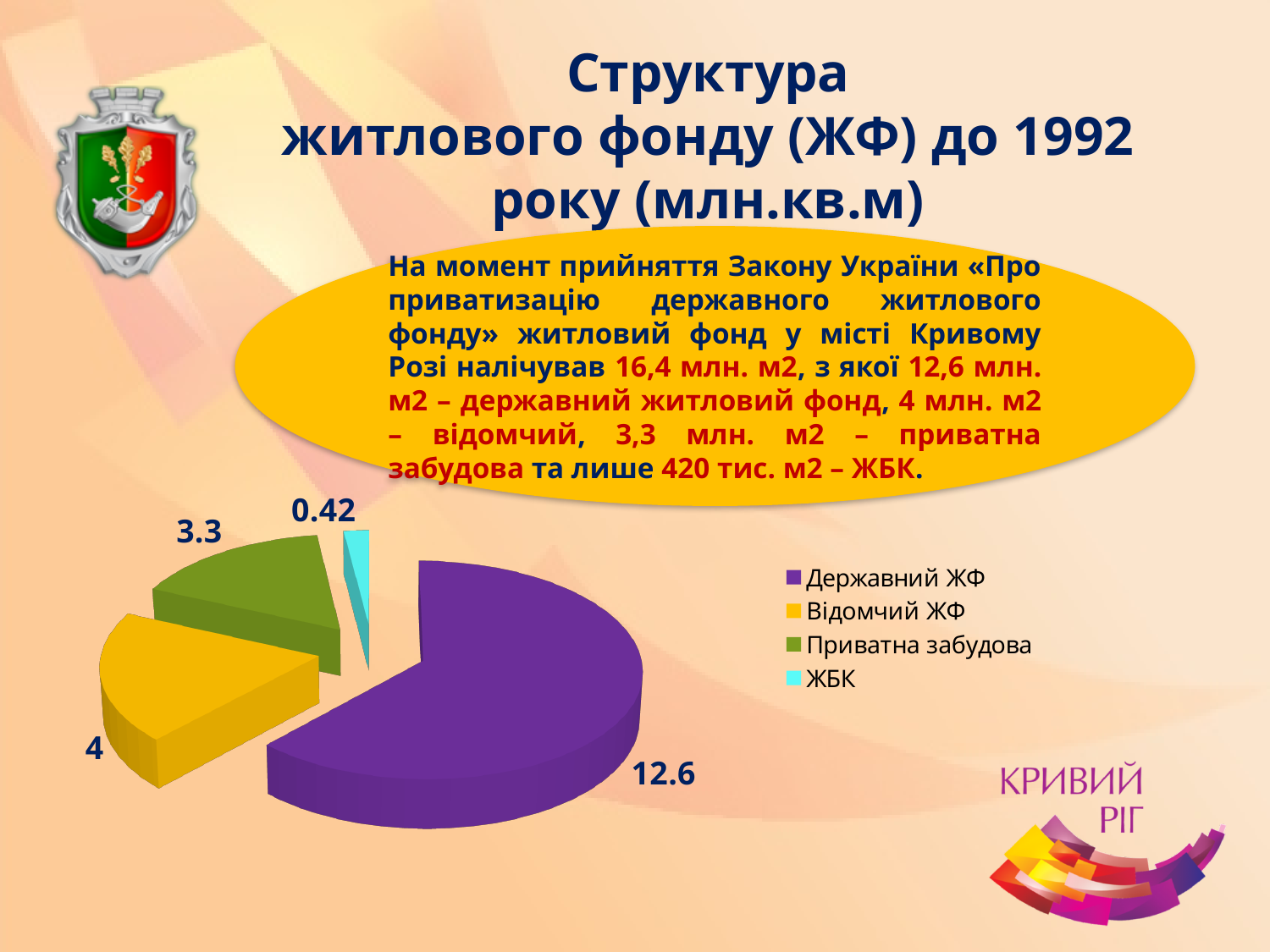
Which category has the smallest slice of the pie? ЖБК What is the value of the Державний ЖФ slice? 12.6 What is the value of the Відомчий ЖФ slice? 4 What type of chart is shown on the slide? pie chart What is the value of the ЖБК slice? 0.42 What is the difference between the Державний ЖФ and Відомчий ЖФ values? 8.6 What is the difference between the Відомчий ЖФ and Приватна забудова values? 0.7 How many slices does the pie chart have? 4 What is the value of the Приватна забудова slice? 3.3 Which category has the largest slice of the pie? Державний ЖФ Which is larger, Приватна забудова or ЖБК? Приватна забудова What colour is the Державний ЖФ slice? purple